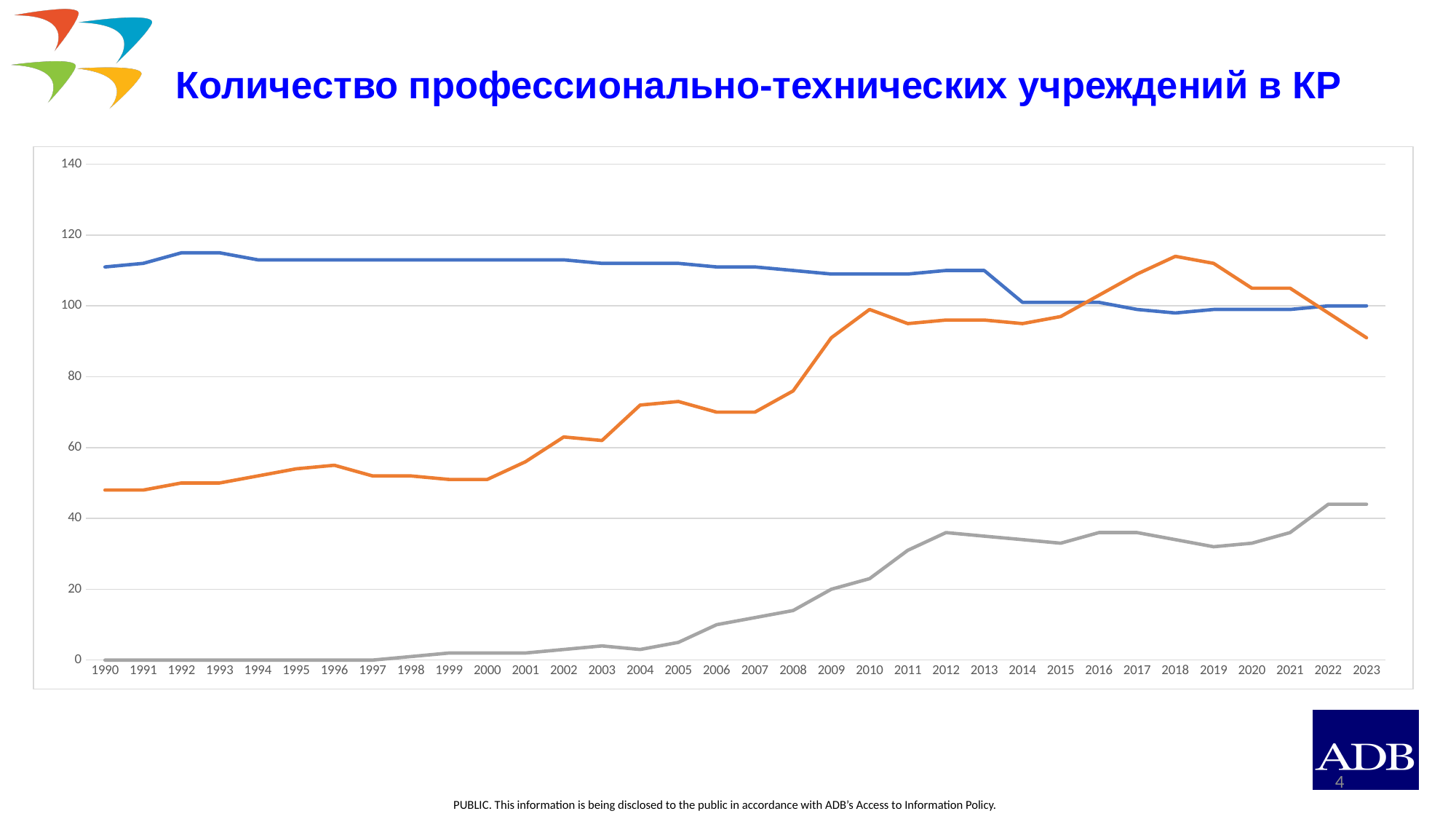
Does the gray line generally rise or fall from 1990 to 2023? rise Is the value of the orange line in 2018 greater or less than 100? greater What is the title of the slide's chart? Количество профессионально-технических учреждений в КР Is the value of the orange line in 1990 greater or less than 60? less Is the value of the gray line in 2023 greater or less than 40? greater How many lines are plotted on the chart? 3 How many years are shown along the x axis of the chart? 34 In 2018, which line has the higher value, the blue line or the orange line? orange line What kind of chart is shown on the slide? line chart Which line has the lowest values across the whole period shown? gray line